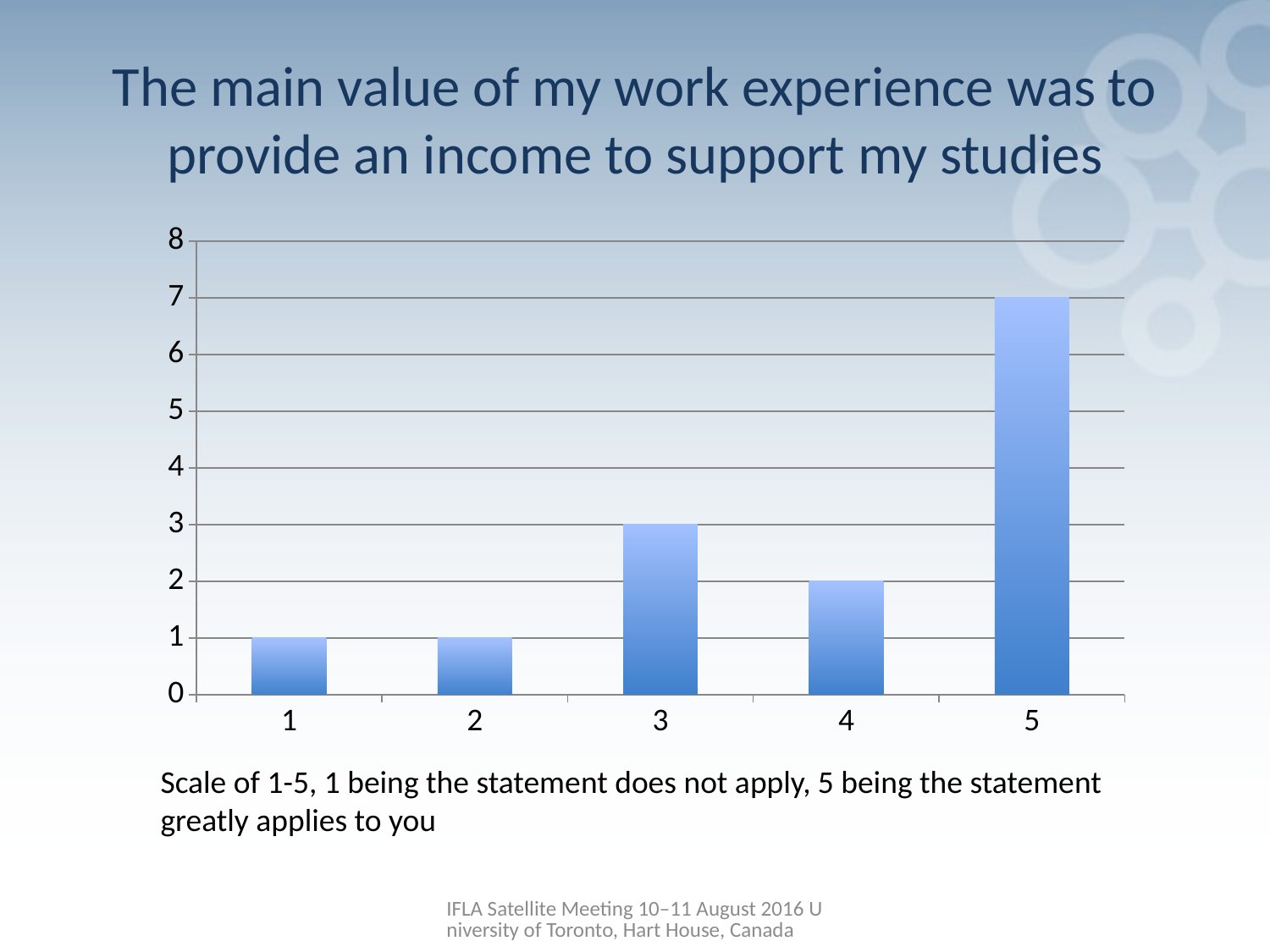
Which is larger, the value for category 3 or the value for category 4? category 3 What is the highest value shown on the y axis? 8 Is the value for category 5 greater or less than 6? greater What is the value for category 5? 7 What kind of chart is shown on the slide? bar chart What is the value for category 4? 2 Which category has the highest value? 5 How many categories are shown on the x axis of the chart? 5 What is the title of the chart on the slide? The main value of my work experience was to provide an income to support my studies What is the value for category 3? 3 What is the difference between the values for category 5 and category 3? 4 What is the value for category 1? 1